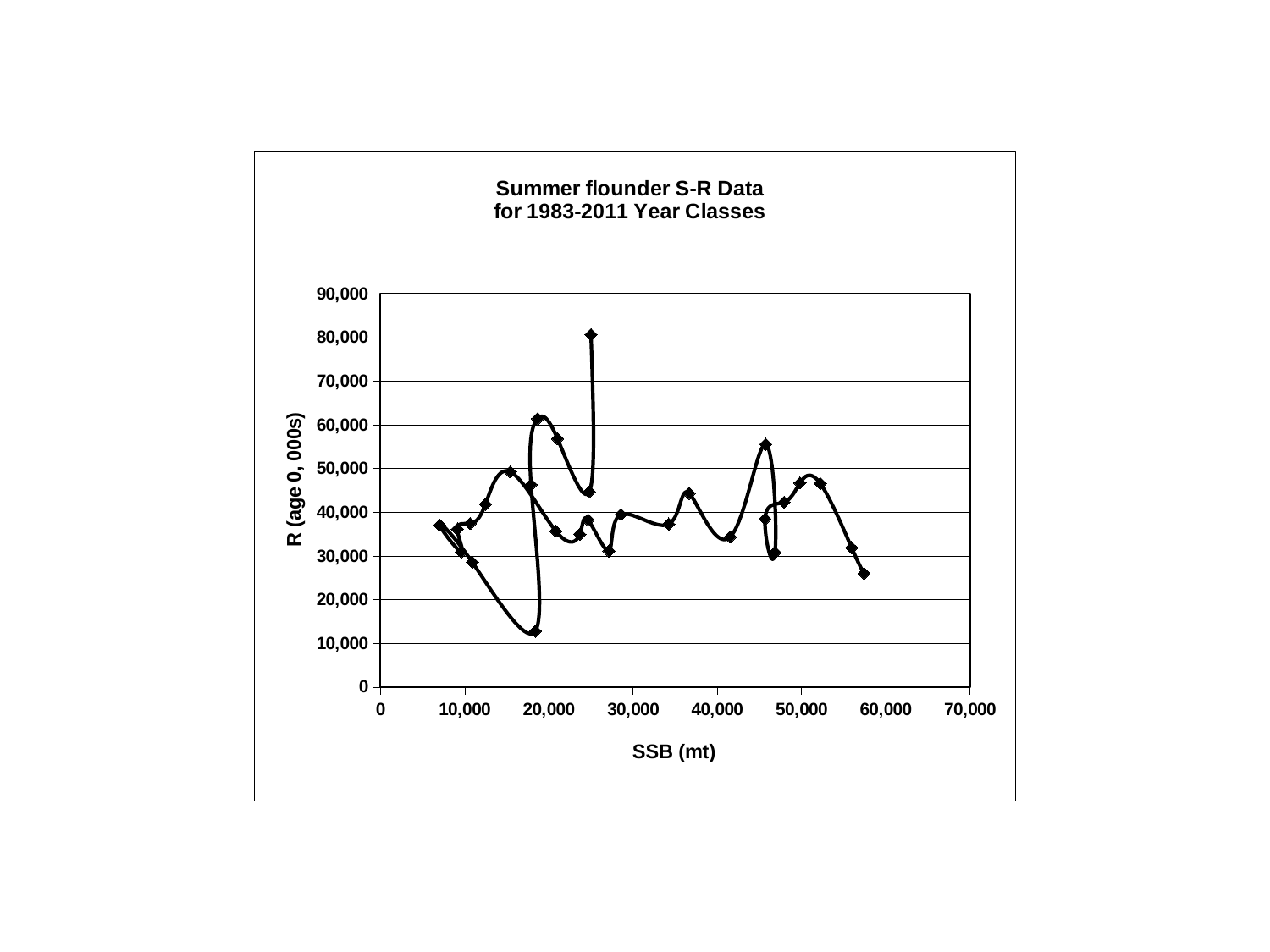
Is the SSB of the point with the lowest recruitment greater or less than 10,000? greater Is the smallest SSB value plotted greater or less than 10,000? less Is the SSB of the point with the highest recruitment greater or less than 20,000? greater What kind of chart is shown on the slide? scatter chart What is the title of the chart? Summer flounder S-R Data for 1983-2011 Year Classes What is the label of the vertical axis? R (age 0, 000s)